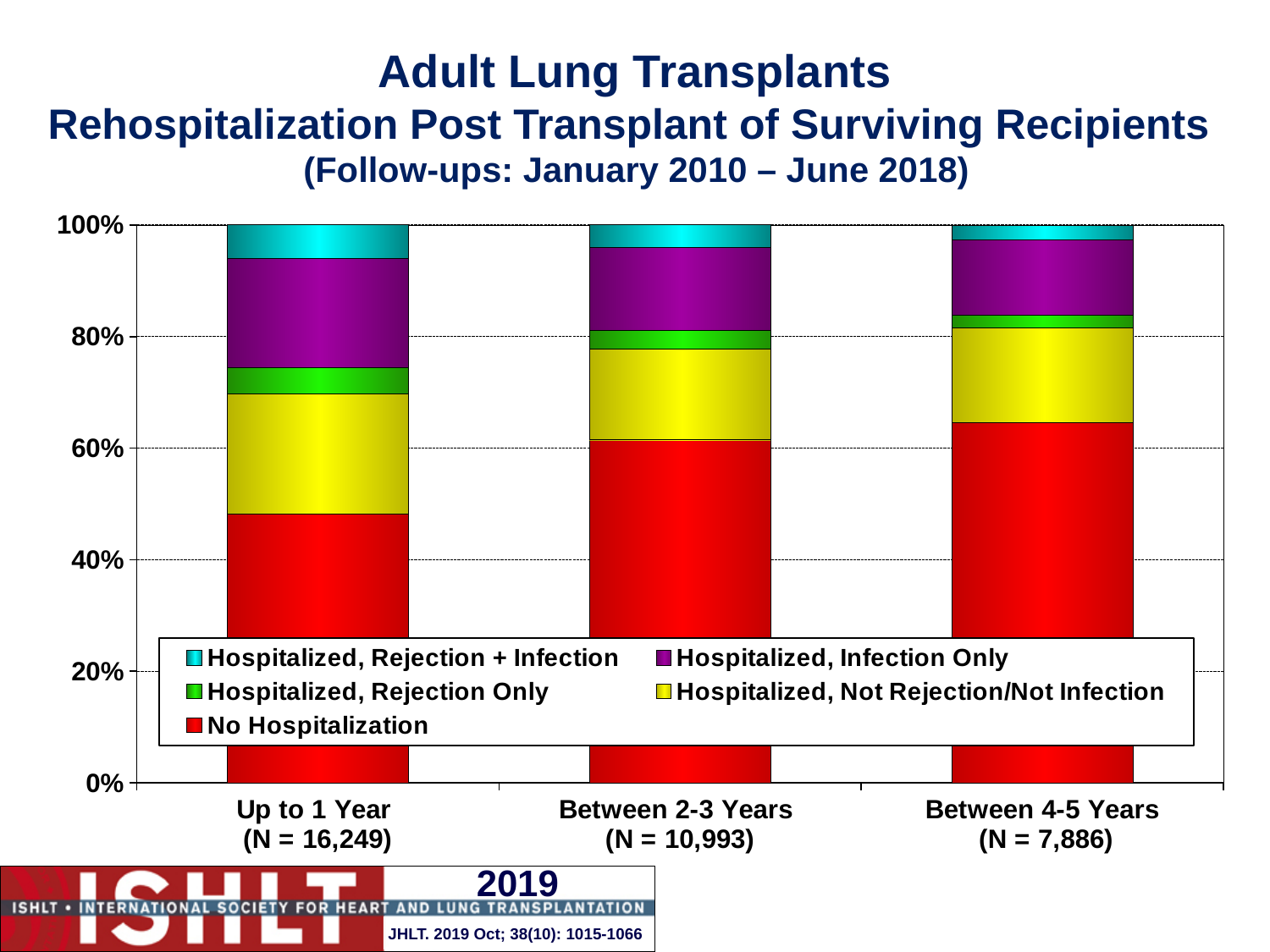
What kind of chart is shown on the slide? Stacked bar chart Is the No Hospitalization share larger for Up to 1 Year or for Between 4-5 Years? Between 4-5 Years How many series does the legend list? 5 What is the total height of the stacked bar for Between 2-3 Years? 100% Does the No Hospitalization share rise or fall moving from Up to 1 Year to Between 4-5 Years? rises How many time-period categories are shown on the x axis? 3 What is the N shown for the Up to 1 Year category? N = 16,249 Which category has the smallest No Hospitalization share? Up to 1 Year Is the No Hospitalization share for Up to 1 Year greater or less than 60%? less Which category has the largest No Hospitalization share? Between 4-5 Years Is the No Hospitalization share for Up to 1 Year greater or less than 40%? greater Is the No Hospitalization share for Between 4-5 Years greater or less than 60%? greater